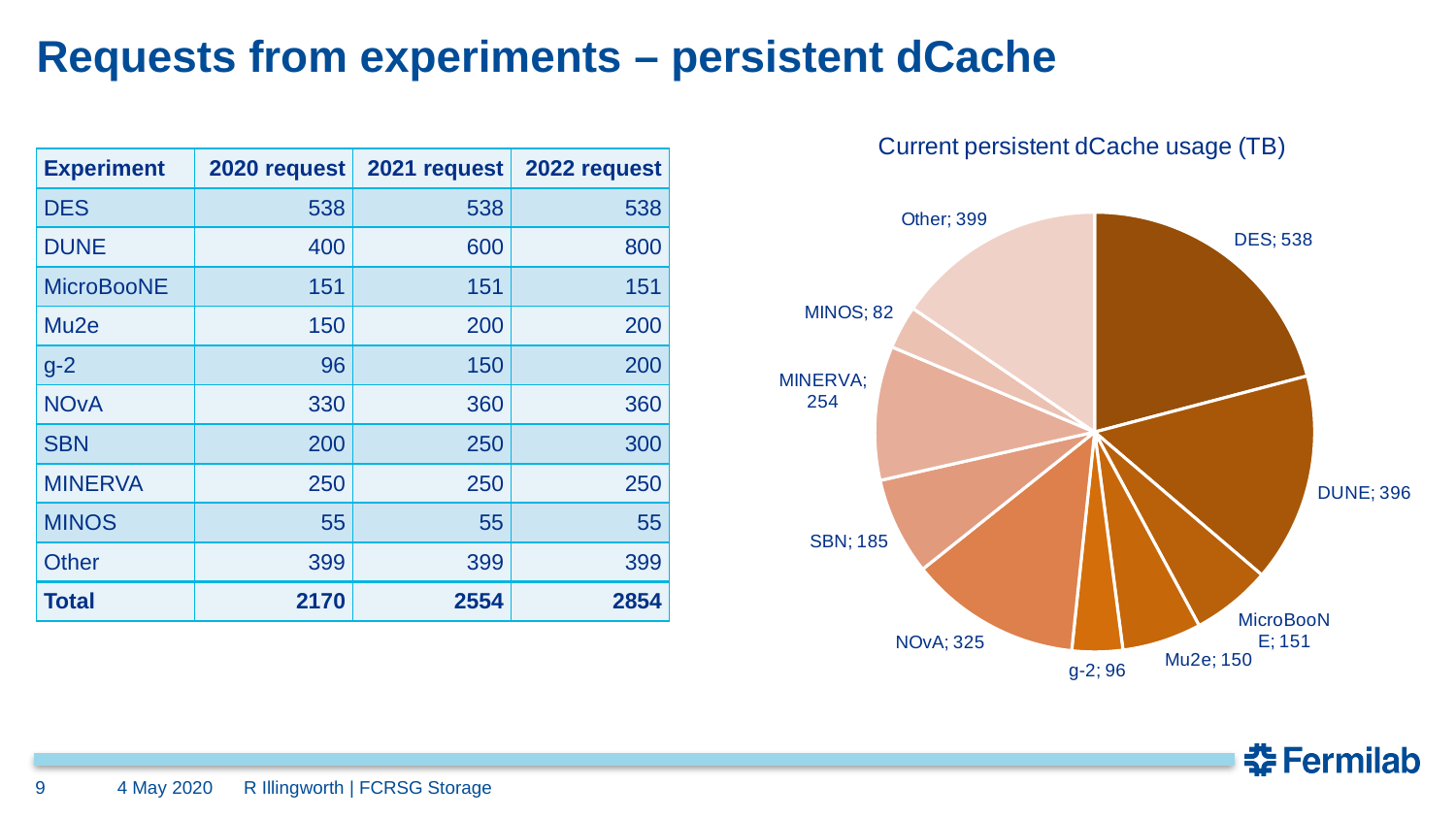
What kind of chart is shown on the slide? pie chart What is the current persistent dCache usage for DES? 538 What is the current persistent dCache usage for g-2? 96 Which experiment has the smallest slice in the pie chart? MINOS Which is larger in the pie chart, NOvA or SBN? NOvA Which experiment has the largest slice in the pie chart? DES What is the difference between the DES and DUNE values in the pie chart? 142 What is the difference between the MicroBooNE and Mu2e values in the pie chart? 1 How many slices does the pie chart have? 10 What is the current persistent dCache usage for DUNE? 396 What is the current persistent dCache usage for MINERVA? 254 What is the title of the chart? Current persistent dCache usage (TB)